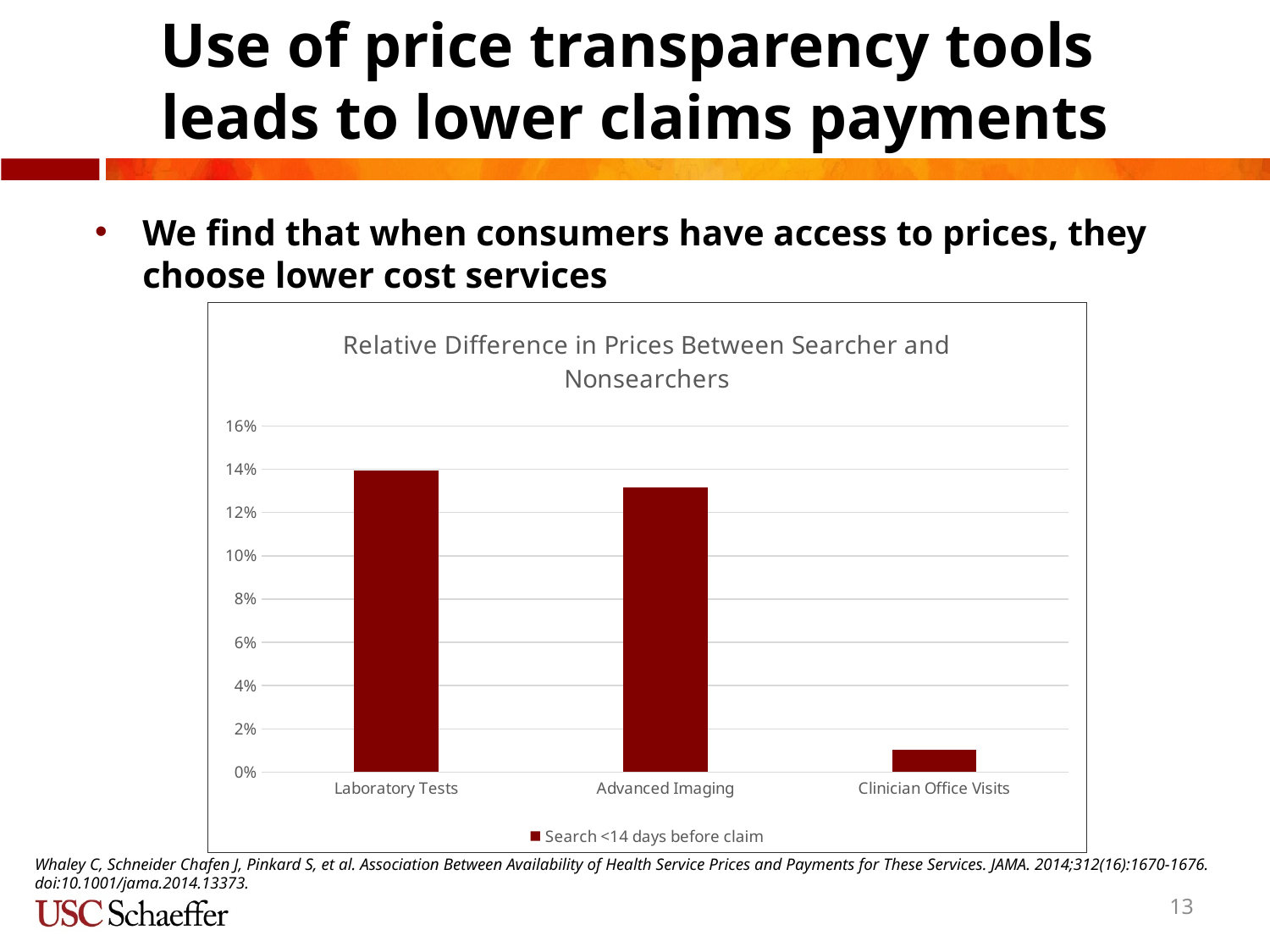
Is the value for Laboratory Tests greater or less than 12%? greater What is the series name shown in the chart legend? Search <14 days before claim Is the value for Clinician Office Visits greater or less than 2%? less Which is larger, the value for Advanced Imaging or the value for Clinician Office Visits? Advanced Imaging Is the value for Advanced Imaging greater or less than 14%? less What is the title of the chart? Relative Difference in Prices Between Searcher and Nonsearchers Which category has the highest value in the chart? Laboratory Tests Which category has the lowest value in the chart? Clinician Office Visits How many categories are shown on the x axis of the chart? 3 How many series does the chart legend list? 1 What kind of chart is shown on the slide? bar chart